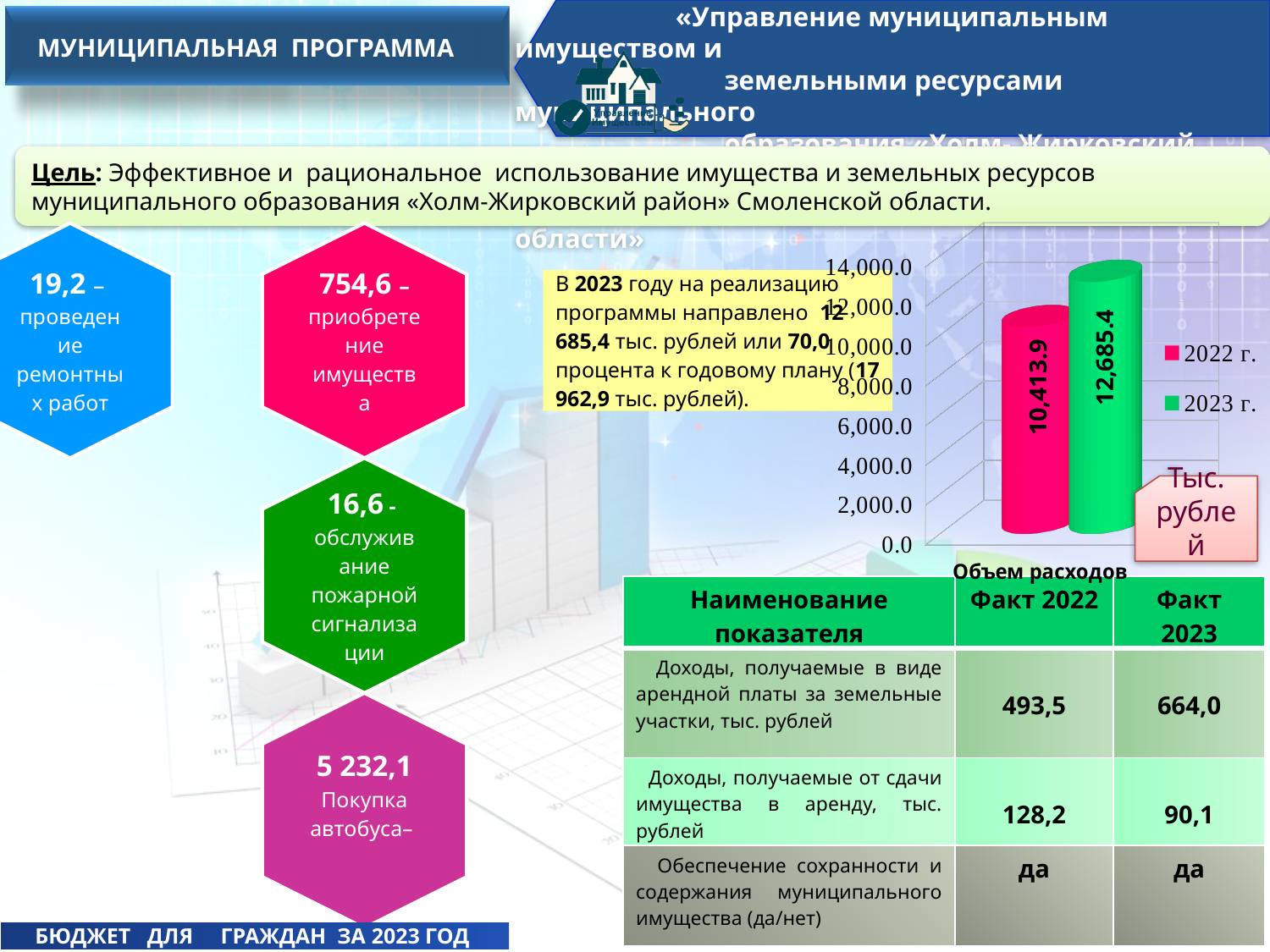
Is the value for 2022 г. greater or less than 12,000.0? less What is the category label shown under the bars of the chart? Объем расходов Is the value for 2023 г. greater or less than 12,000.0? greater What kind of chart is shown on the slide? bar chart What is the highest value shown on the chart's vertical axis? 14,000.0 How many series does the chart legend list? 2 Which series has the lowest value in the chart? 2022 г. Which series has the higher value in the chart, 2022 г. or 2023 г.? 2023 г. Which series has the highest value in the chart? 2023 г. What is the value for 2022 г. in the chart? 10,413.9 What is the value for 2023 г. in the chart? 12,685.4 What is the difference between the 2023 г. and 2022 г. values in the chart? 2,271.5